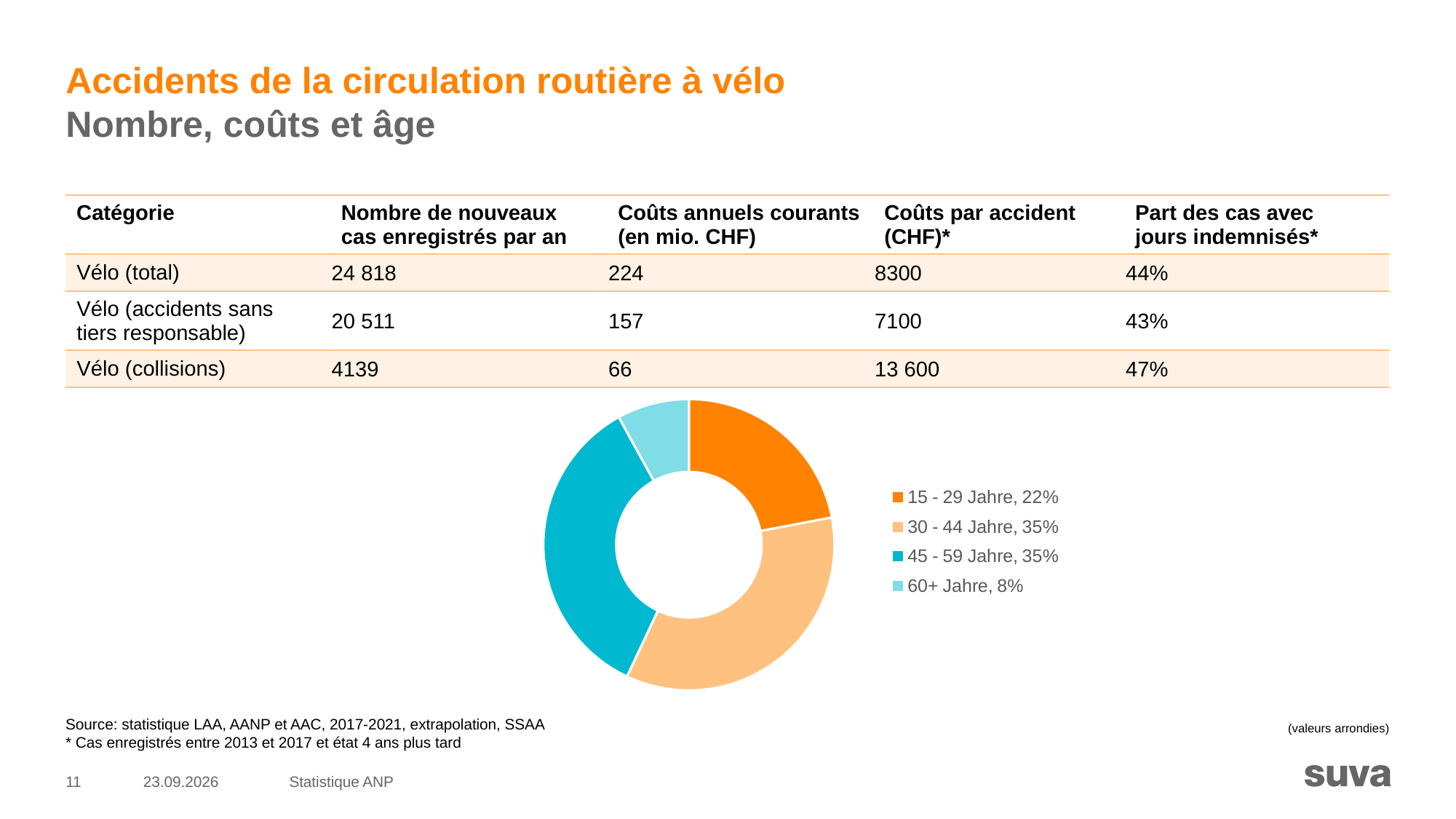
What share of the doughnut chart is the 60+ Jahre category? 8% What share of the doughnut chart is the 45 - 59 Jahre category? 35% What share of the doughnut chart is the 30 - 44 Jahre category? 35% Which age category is shown in light blue in the doughnut chart? 60+ Jahre Which colour represents the 15 - 29 Jahre category in the doughnut chart? Orange Which is larger in the doughnut chart: the share for 15 - 29 Jahre or for 60+ Jahre? 15 - 29 Jahre What is the difference between the shares for 15 - 29 Jahre and 60+ Jahre in the doughnut chart? 14% Which age category has the smallest share in the doughnut chart? 60+ Jahre What share of the doughnut chart is the 15 - 29 Jahre category? 22% What kind of chart is shown on the slide? Doughnut (pie) chart How many age categories does the doughnut chart show? 4 What is the combined share of the 30 - 44 Jahre and 45 - 59 Jahre categories in the doughnut chart? 70%